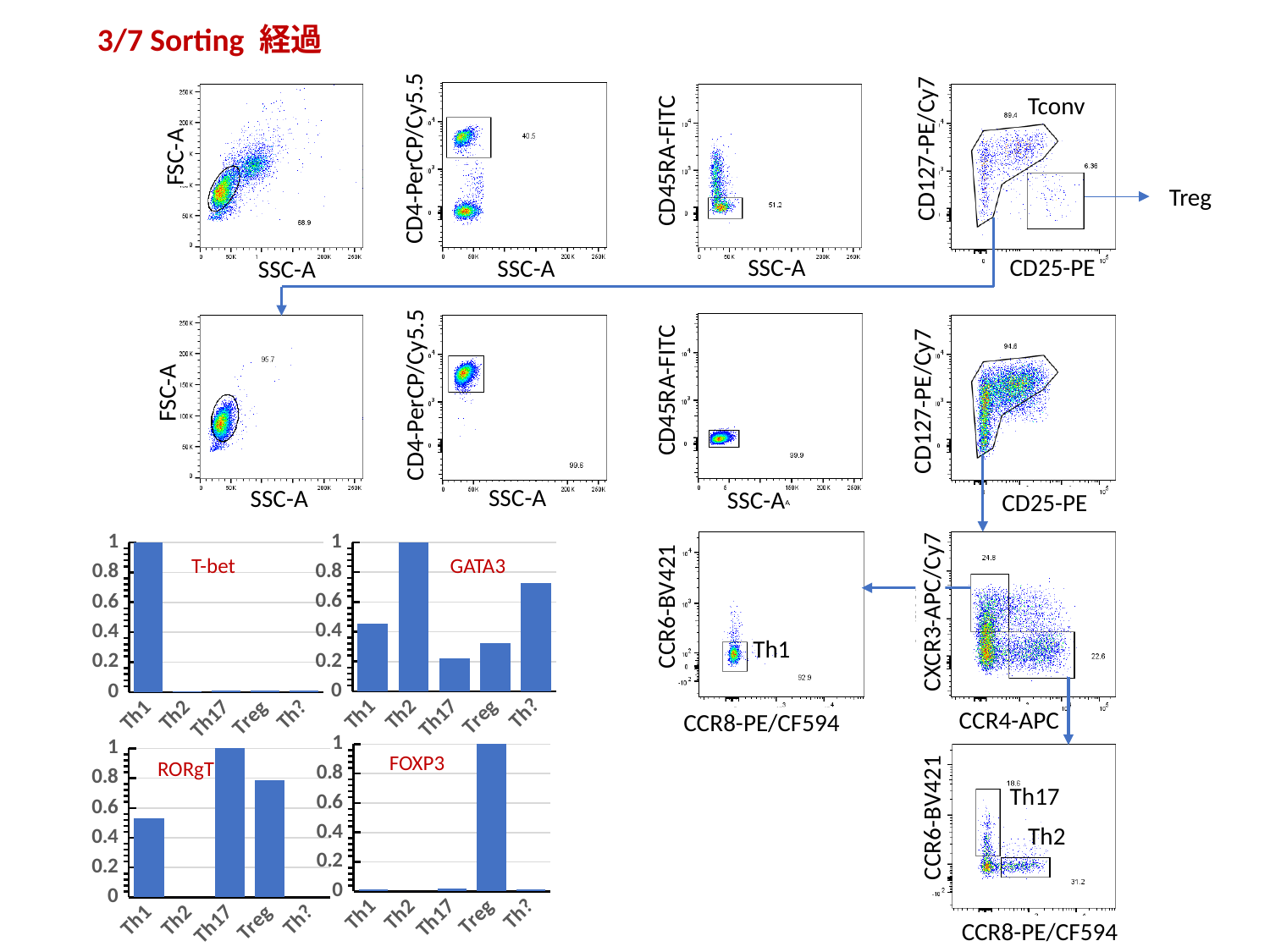
In the FOXP3 bar chart, which category has the highest value? Treg In the GATA3 bar chart, which category has the highest value? Th2 In the GATA3 bar chart, is the value for Th1 greater or less than 0.6? less In the GATA3 bar chart, which category has the lowest value? Th17 What kind of chart is the T-bet chart? bar chart In the GATA3 bar chart, is the value for Th? greater or less than 0.6? greater In the GATA3 bar chart, which is larger, the value for Th1 or the value for Treg? Th1 How many categories are shown on the x axis of the FOXP3 bar chart? 5 In the RORgT bar chart, is the value for Treg greater or less than 0.6? greater In the RORgT bar chart, which is larger, the value for Th1 or the value for Treg? Treg In the RORgT bar chart, which category has the highest value? Th17